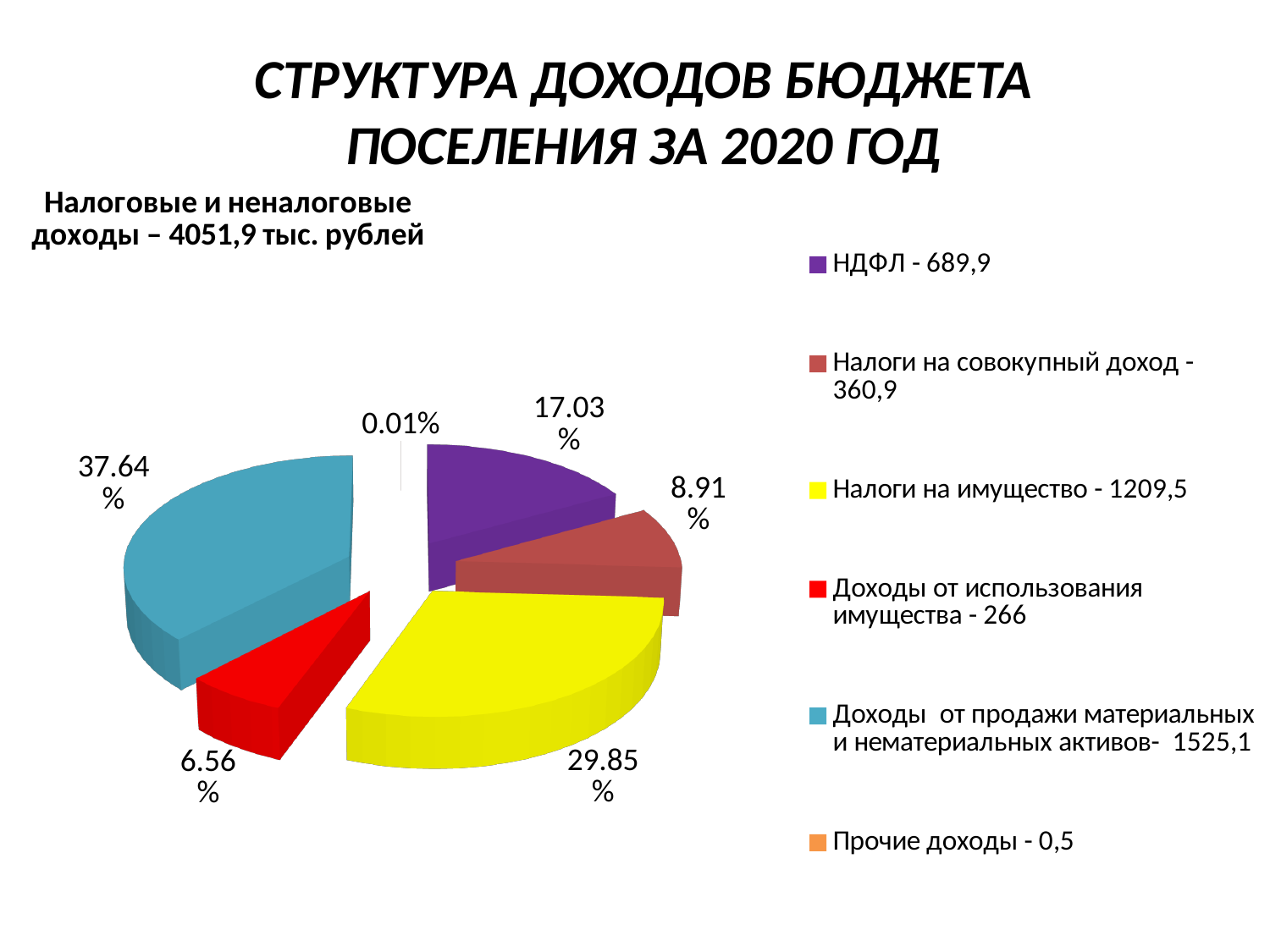
What is the difference in percentage points between the Доходы от продажи материальных и нематериальных активов slice and the Налоги на имущество slice? 7.79% What share of the pie does the НДФЛ slice represent? 17.03% Which slice is larger: НДФЛ or Налоги на совокупный доход? НДФЛ Which category has the smallest slice of the pie? Прочие доходы What share of the pie does the Доходы от продажи материальных и нематериальных активов slice represent? 37.64% Which category has the largest slice of the pie? Доходы от продажи материальных и нематериальных активов What share of the pie does the Налоги на имущество slice represent? 29.85% How many categories does the legend list? 6 What kind of chart is shown on the slide? pie chart What value is shown in the legend for Налоги на имущество? 1209,5